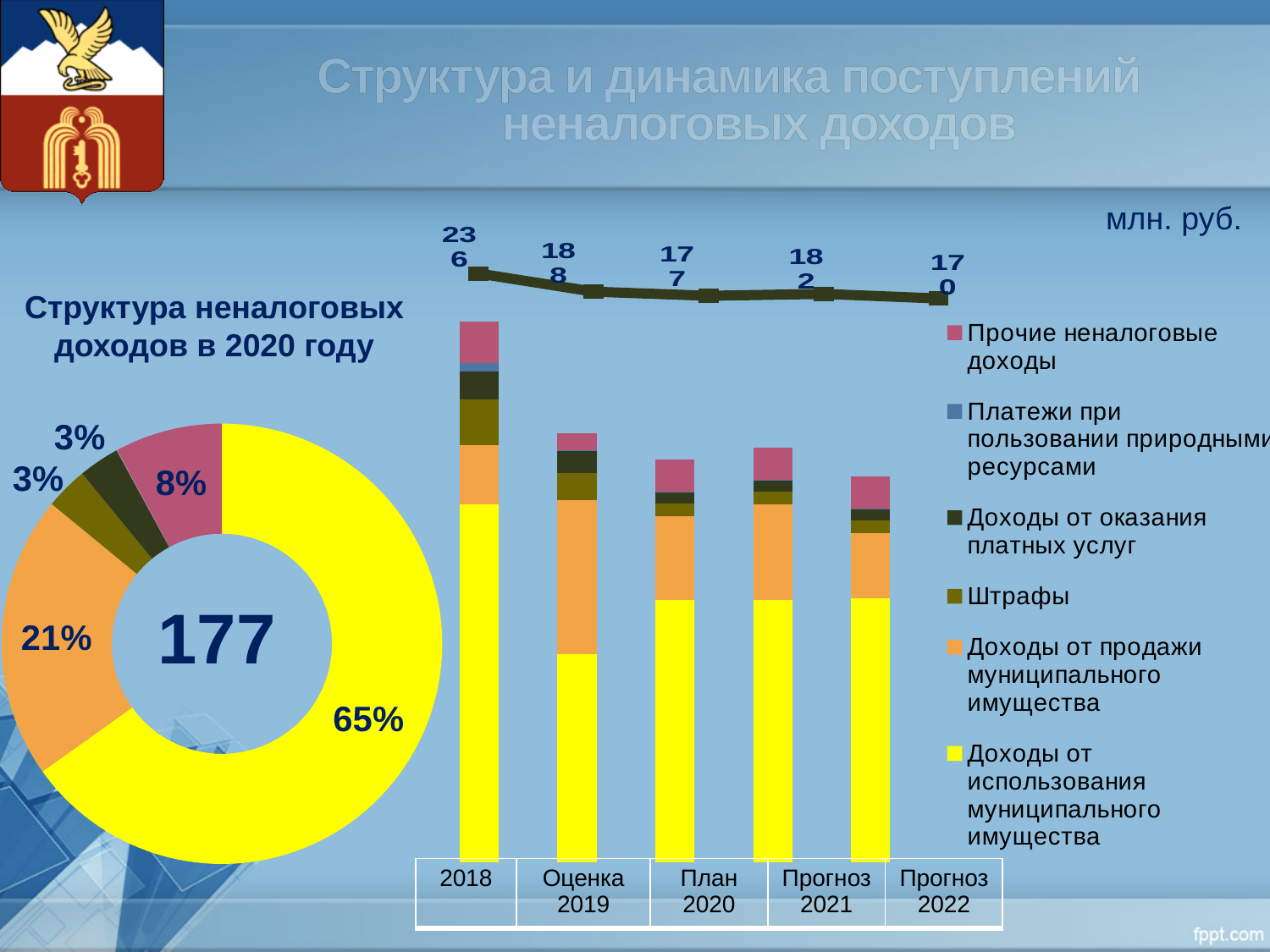
In the chart 'Структура неналоговых доходов в 2020 году', what share is shown for the largest (yellow) slice? 65% On the stacked bar chart on the right, what is the difference between the totals for 2018 and Оценка 2019? 48 On the stacked bar chart on the right, which total is larger: Прогноз 2021 or Прогноз 2022? Прогноз 2021 On the stacked bar chart on the right, which year has the lowest total? Прогноз 2022 On the stacked bar chart on the right, which year has the highest total? 2018 How many series does the legend of the stacked bar chart on the right list? 6 On the stacked bar chart on the right, what total value is shown for 2018? 236 In the chart 'Структура неналоговых доходов в 2020 году', what share is shown for the orange slice? 21% What number is shown in the centre of the chart 'Структура неналоговых доходов в 2020 году'? 177 On the stacked bar chart on the right, what total value is shown for План 2020? 177 On the stacked bar chart on the right, what total value is shown for Прогноз 2022? 170 How many categories (years) are shown on the stacked bar chart on the right? 5